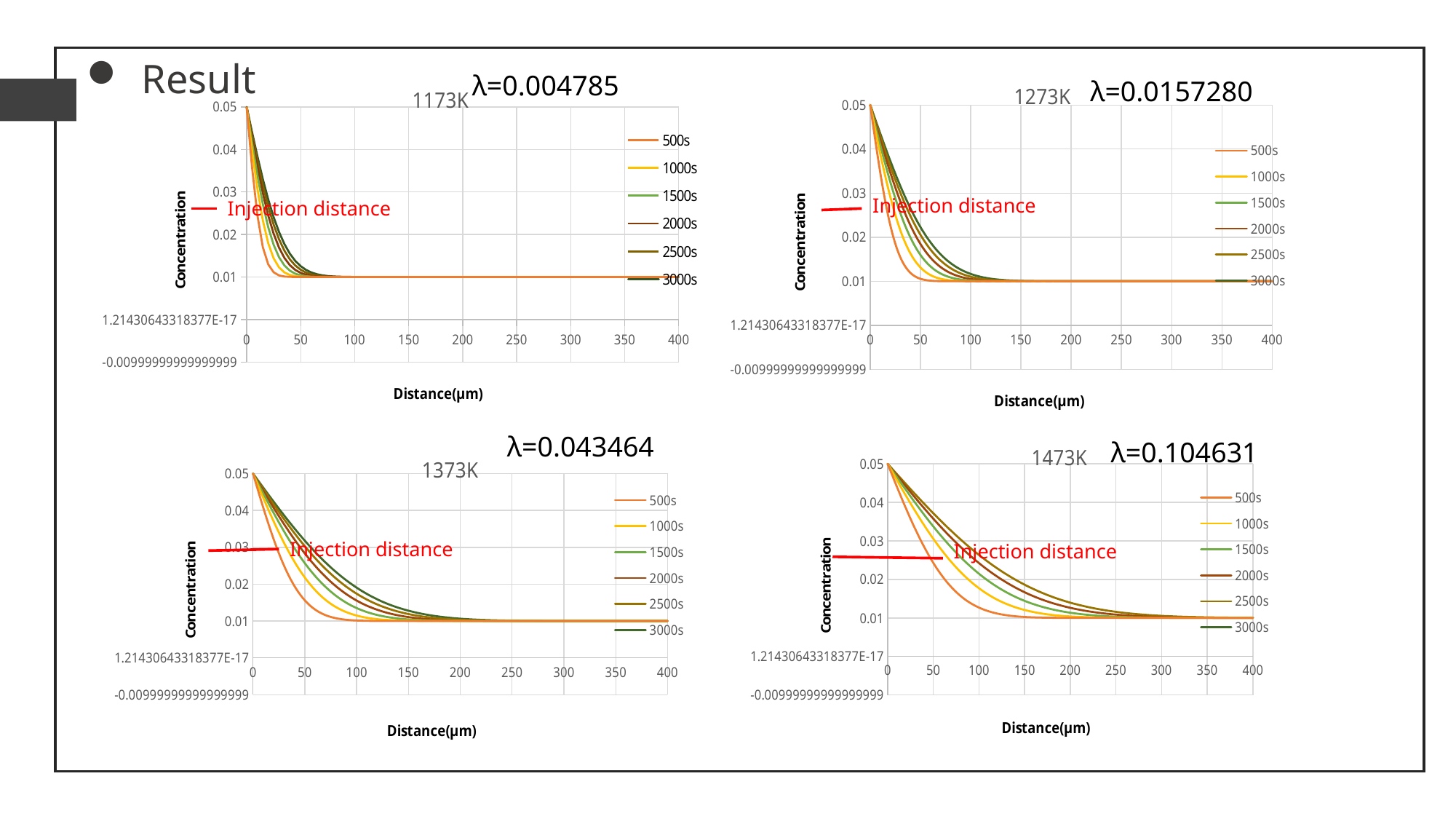
In the 1473K chart, is the concentration of the 3000s series at a distance of 100 μm greater or less than 0.02? greater How many series does the legend of the 1273K chart list? 6 What is the x-axis label of the 1273K chart? Distance(μm) In the 1273K chart, is the concentration of the 1000s series at a distance of 50 μm greater or less than 0.03? less What is the λ value shown for the 1473K chart? λ=0.104631 In the 1173K chart, what concentration do all the series level off to at a distance of 400 μm? 0.01 In the 1173K chart, is the concentration of the 500s series at a distance of 50 μm greater or less than 0.02? less What kind of chart is the 1173K chart? line chart In the 1473K chart, do the concentration values rise or fall as distance increases? fall How many charts are shown on the slide? 4 In the 1373K chart, at a distance of 100 μm, which series has the higher concentration, 500s or 3000s? 3000s In the 1373K chart, what is the concentration of the 500s series at a distance of 0 μm? 0.05